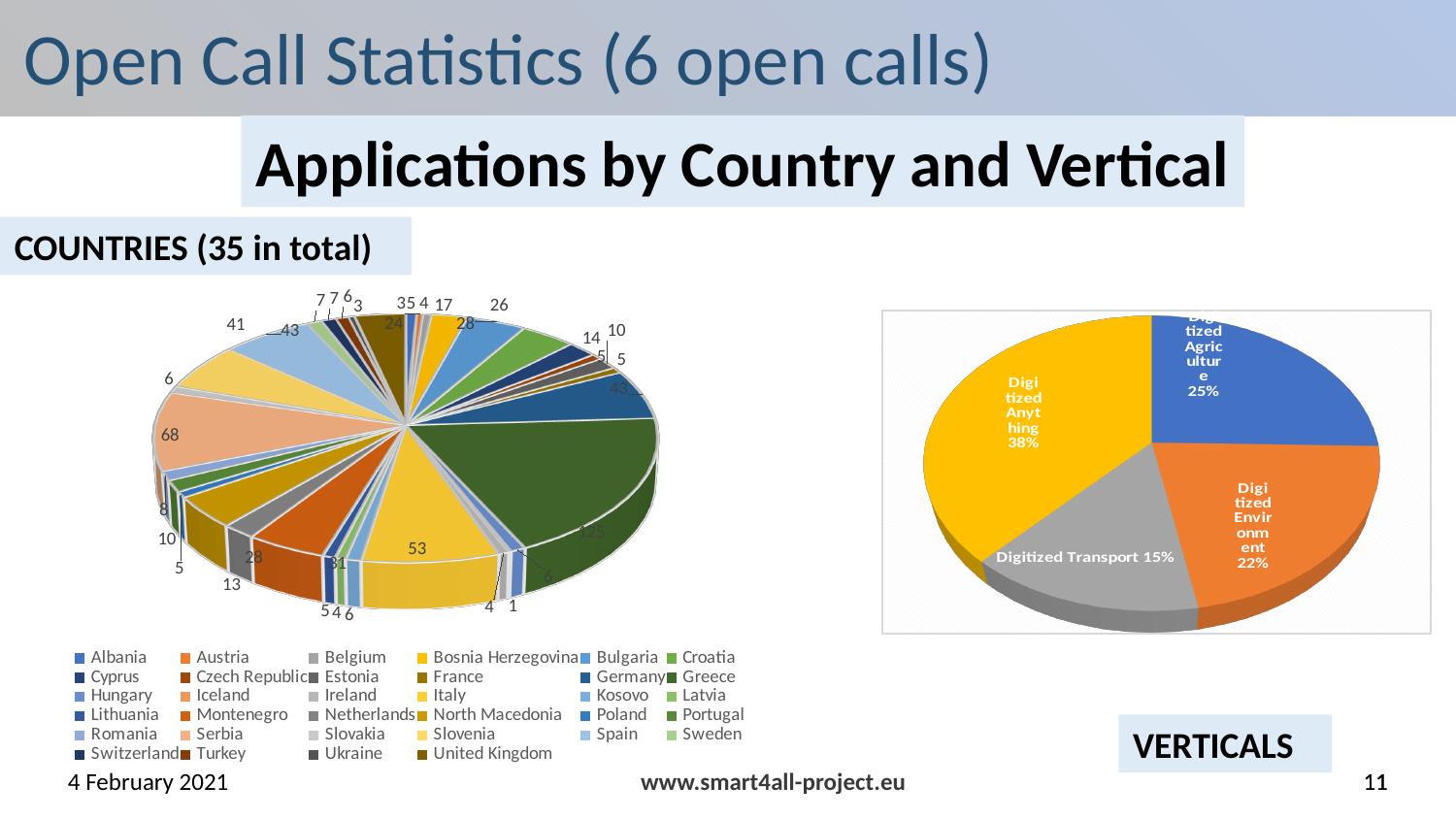
What is the largest value labelled on the COUNTRIES pie chart? 125 On the VERTICALS chart, which vertical has the smallest share? Digitized Transport On the VERTICALS chart, what share of applications is Digitized Agriculture? 25% On the VERTICALS chart, what share of applications is Digitized Environment? 22% What kind of chart is the VERTICALS chart? Pie chart How many slices does the VERTICALS chart have? 4 On the VERTICALS chart, what is the difference in percentage points between Digitized Anything and Digitized Transport? 23 On the VERTICALS chart, which vertical has the largest share? Digitized Anything According to the heading above the countries chart, how many countries are represented in total? 35 On the VERTICALS chart, what share of applications is Digitized Transport? 15% On the VERTICALS chart, which is larger: Digitized Agriculture or Digitized Environment? Digitized Agriculture